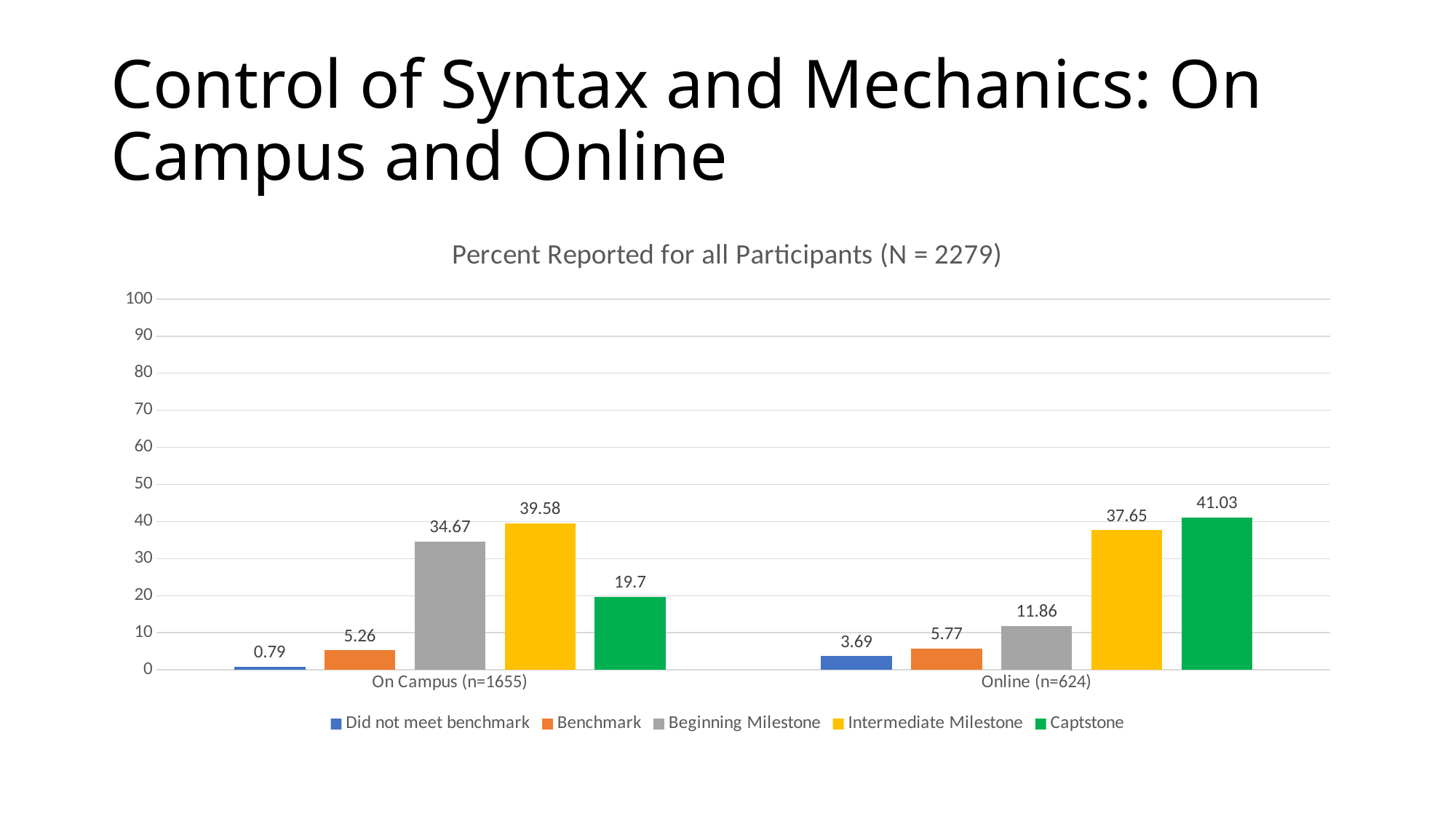
Which series has the highest value in the Online (n=624) group? Captstone Which series has the lowest value in the On Campus (n=1655) group? Did not meet benchmark What kind of chart is shown on the slide? Bar chart Which is larger: Beginning Milestone for On Campus (n=1655) or Beginning Milestone for Online (n=624)? On Campus (n=1655) Is the value for Beginning Milestone in the Online (n=624) group greater or less than 20? less What is the title of the chart? Percent Reported for all Participants (N = 2279) What is the value for Did not meet benchmark in the Online (n=624) group? 3.69 What is the difference between the Captstone values for Online (n=624) and On Campus (n=1655)? 21.33 Which series has the highest value in the On Campus (n=1655) group? Intermediate Milestone What is the value for Captstone in the Online (n=624) group? 41.03 What is the value for Intermediate Milestone in the On Campus (n=1655) group? 39.58 How many series does the legend list? 5